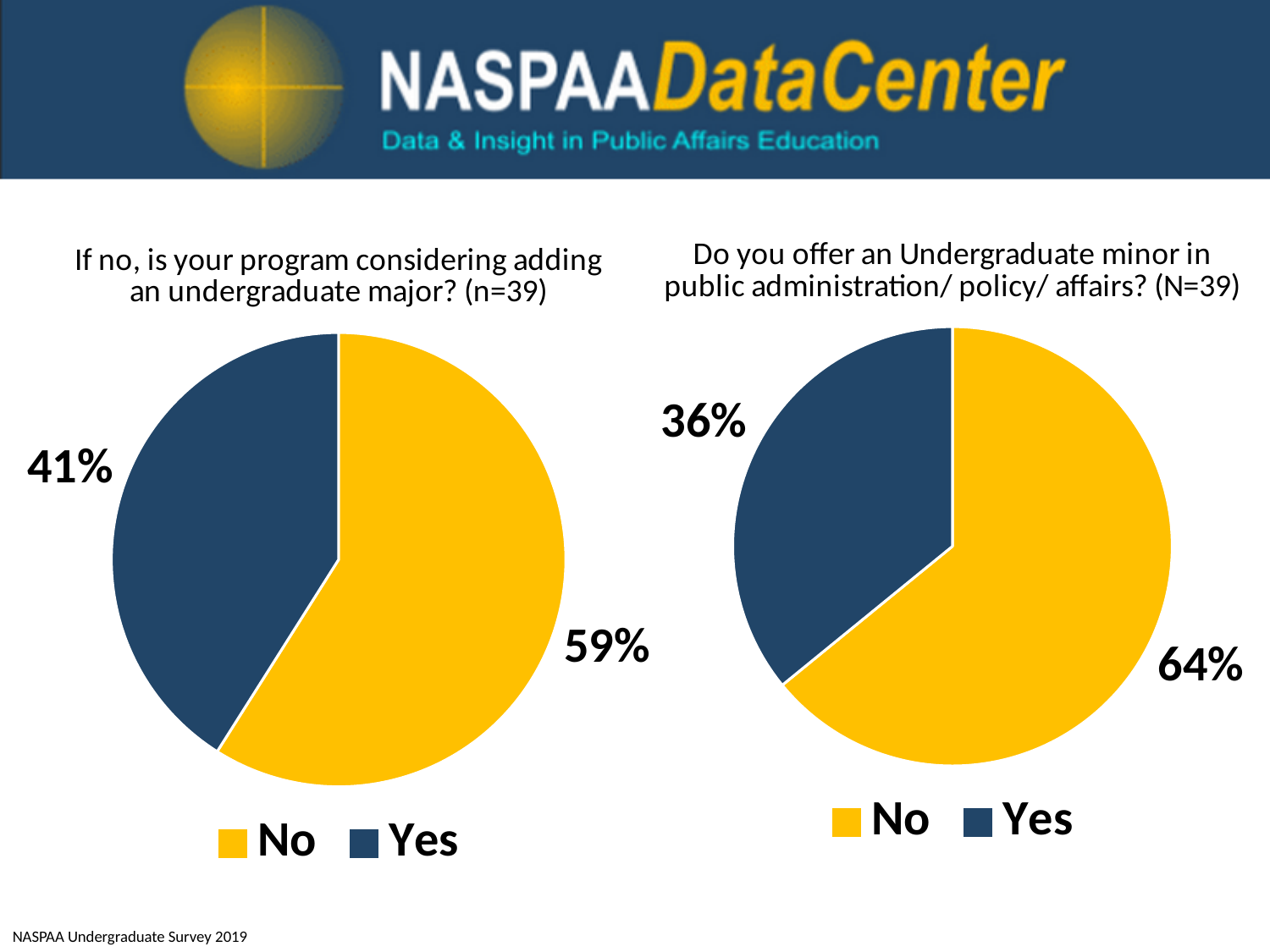
Is the Yes share in the right chart larger or smaller than the Yes share in the left chart? smaller In the right chart ("Do you offer an Undergraduate minor in public administration/ policy/ affairs?"), what share of respondents answered No? 64% In the left chart, which response has the larger share, No or Yes? No In the left chart ("If no, is your program considering adding an undergraduate major?"), what share of respondents answered No? 59% How many slices does the left pie chart have? 2 In the right chart ("Do you offer an Undergraduate minor in public administration/ policy/ affairs?"), what share of respondents answered Yes? 36% In the right chart, what is the difference in percentage points between the No and Yes shares? 28 In the right chart, which response has the smaller share? Yes In the right chart, which colour represents the No response? yellow What type of chart is used on the right side of the slide? pie chart In the left chart ("If no, is your program considering adding an undergraduate major?"), what share of respondents answered Yes? 41% In the left chart, what is the difference in percentage points between the No and Yes shares? 18